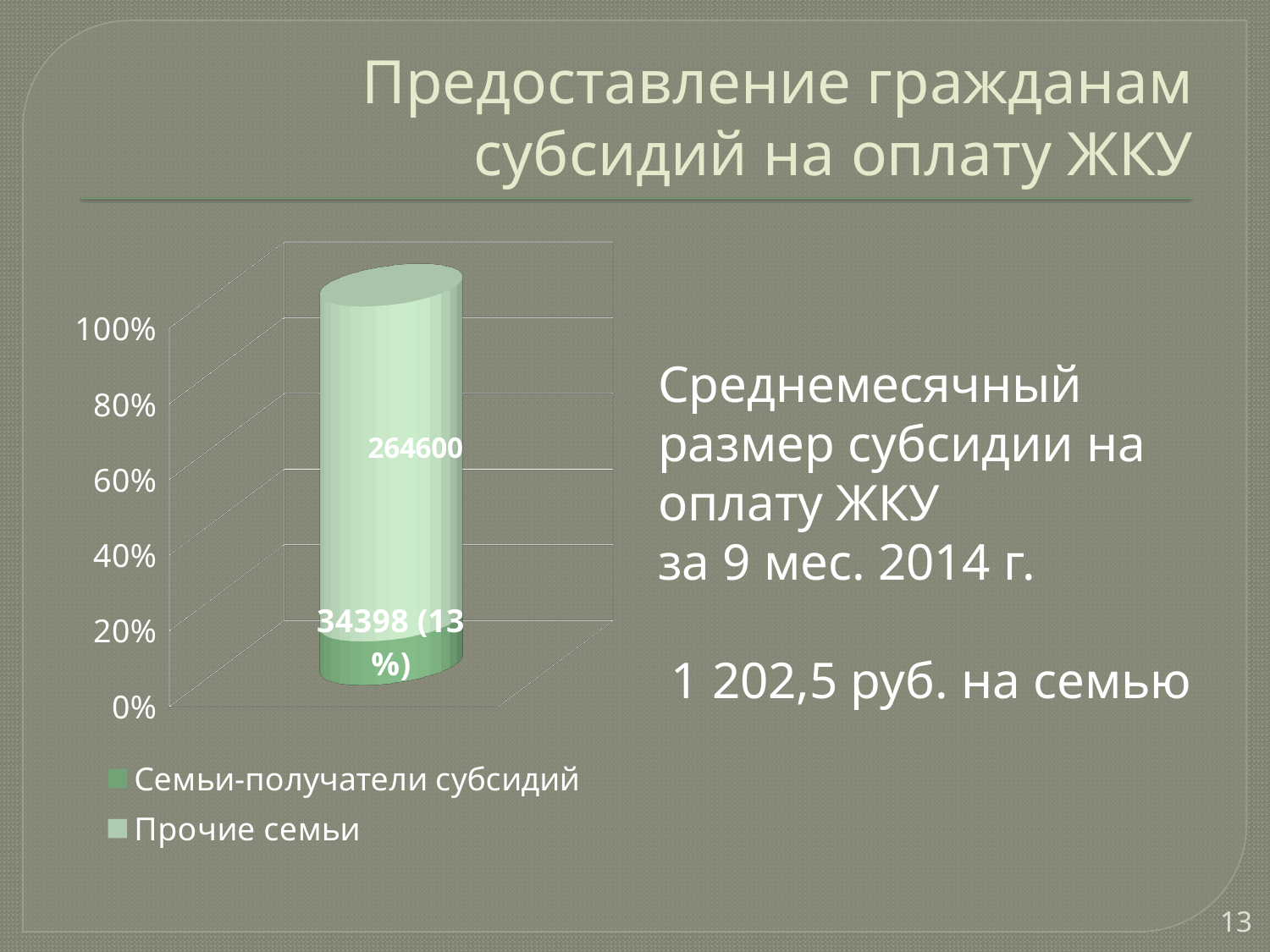
How many bars are plotted in the chart? 1 Is the share of the bar taken by "Семьи-получатели субсидий" greater or less than 20%? less What kind of chart is shown on the slide? bar chart What is the total of the two segments in the stacked bar? 298998 Which legend entry is listed first? Семьи-получатели субсидий What value is shown for the "Прочие семьи" segment of the bar? 264600 Which series has the larger value, "Семьи-получатели субсидий" or "Прочие семьи"? Прочие семьи What percentage share of the bar do "Семьи-получатели субсидий" make up, according to the data label? 13 % What label is printed on the "Семьи-получатели субсидий" segment of the bar? 34398 (13 %) What is the highest value shown on the vertical axis? 100% What is the difference between the value for "Прочие семьи" and the value for "Семьи-получатели субсидий"? 230202 How many series does the legend list? 2